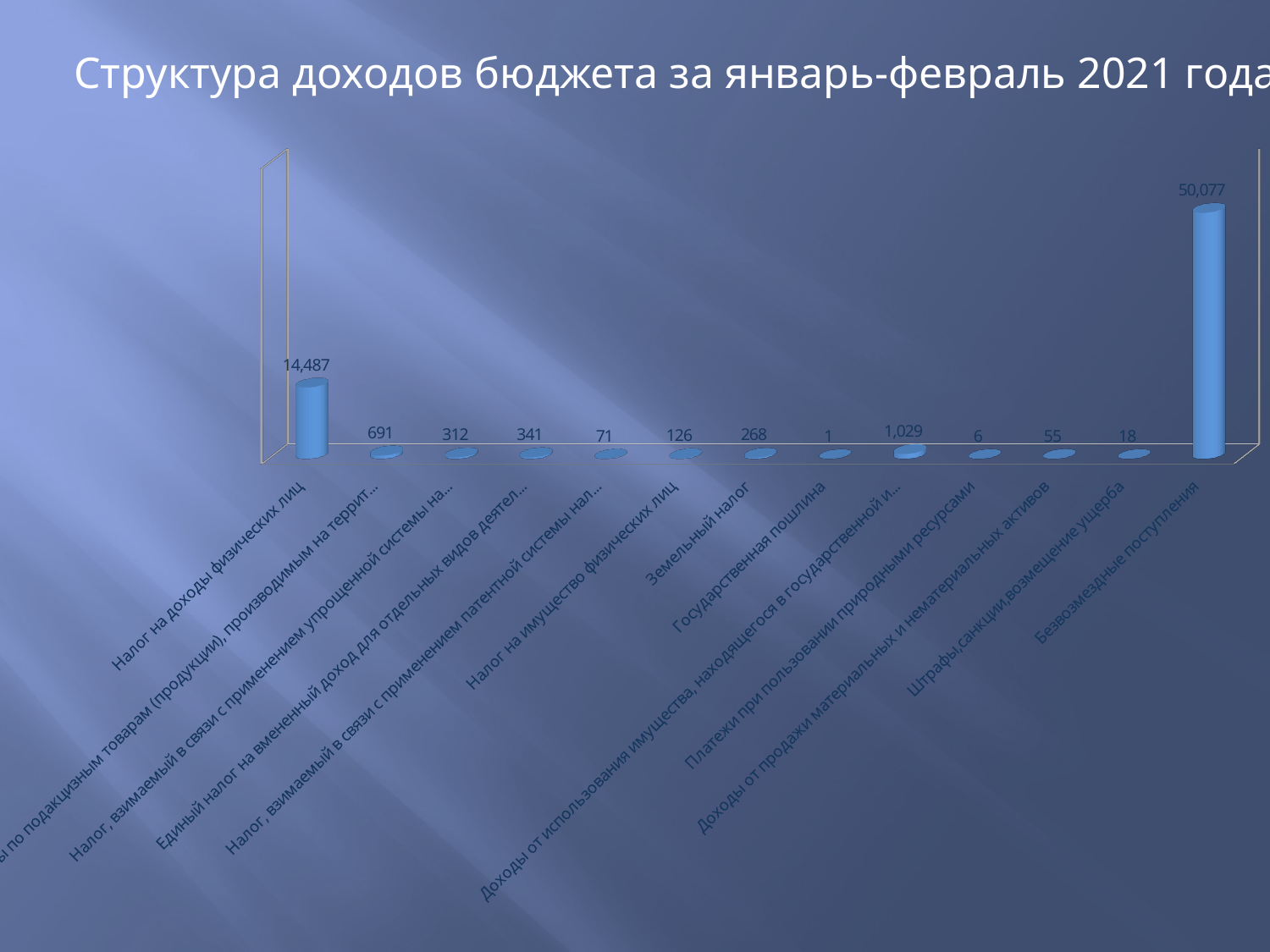
Which category has the highest value? Безвозмездные поступления What is the difference between the values for Безвозмездные поступления and Налог на доходы физических лиц? 35,590 What is the value for Безвозмездные поступления? 50,077 What is the value for Земельный налог? 268 What is the value for Налог на доходы физических лиц? 14,487 How many categories are shown in the chart? 13 Which is larger: the value for Земельный налог or the value for Налог на имущество физических лиц? Земельный налог What is the value for Государственная пошлина? 1 What is the title of the chart? Структура доходов бюджета за январь-февраль 2021 года What is the value for Платежи при пользовании природными ресурсами? 6 Which category has the lowest value? Государственная пошлина What kind of chart is shown on the slide? Bar chart